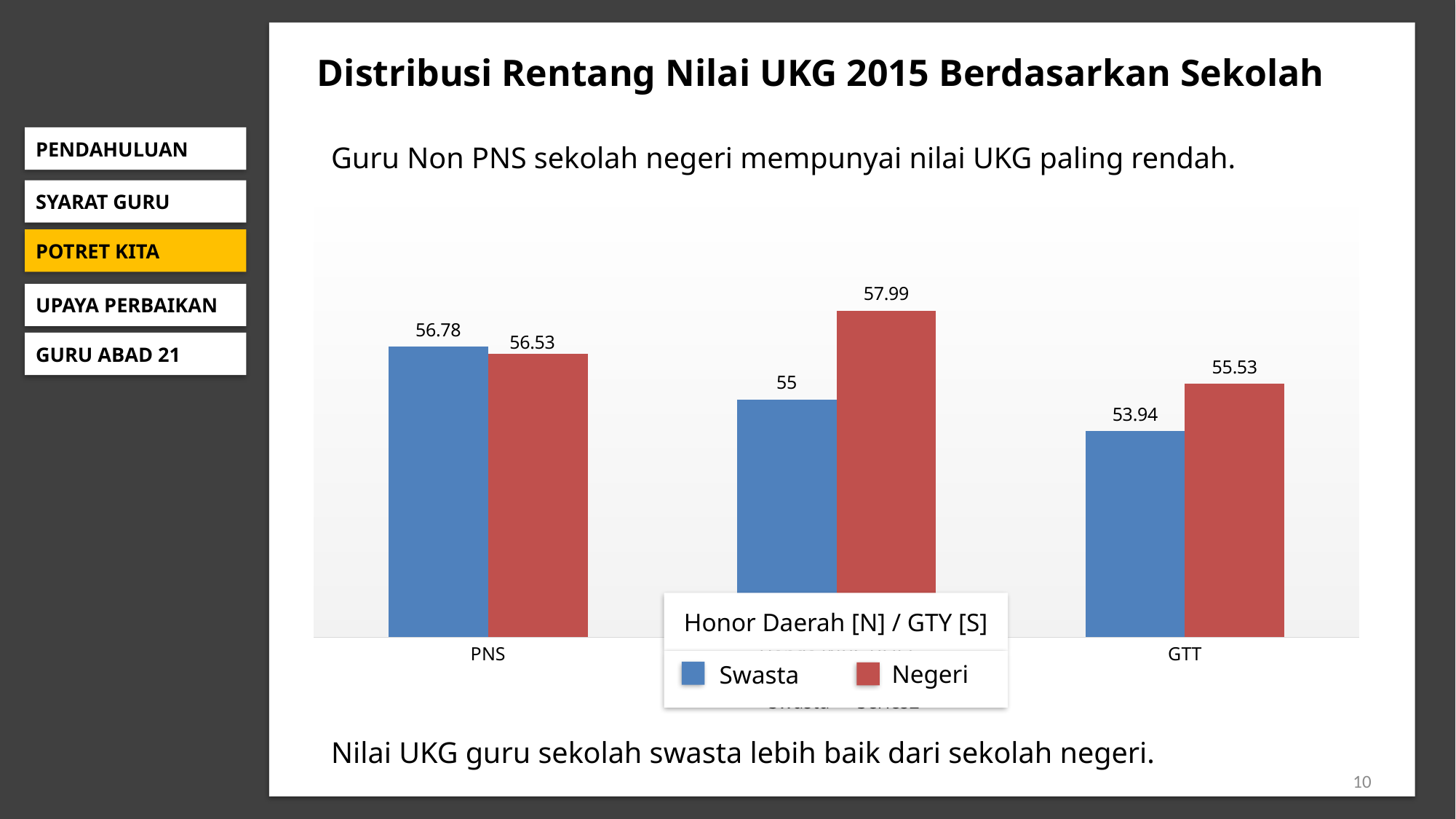
Which category has the lowest Swasta value? GTT What is the Negeri value for the middle category (Honor Daerah [N] / GTY [S])? 57.99 What is the Negeri value for GTT? 55.53 Which category has the highest Negeri value? Honor Daerah [N] / GTY [S] (the middle category) How many categories are shown on the x axis? 3 What is the Swasta value for GTT? 53.94 For GTT, which series has the larger value, Swasta or Negeri? Negeri What is the Swasta value for PNS? 56.78 How many series does the legend list? 2 What kind of chart is shown on the slide? Bar chart What is the difference between the Swasta and Negeri values for PNS? 0.25 What is the difference between the Negeri and Swasta values for the middle category (Honor Daerah [N] / GTY [S])? 2.99